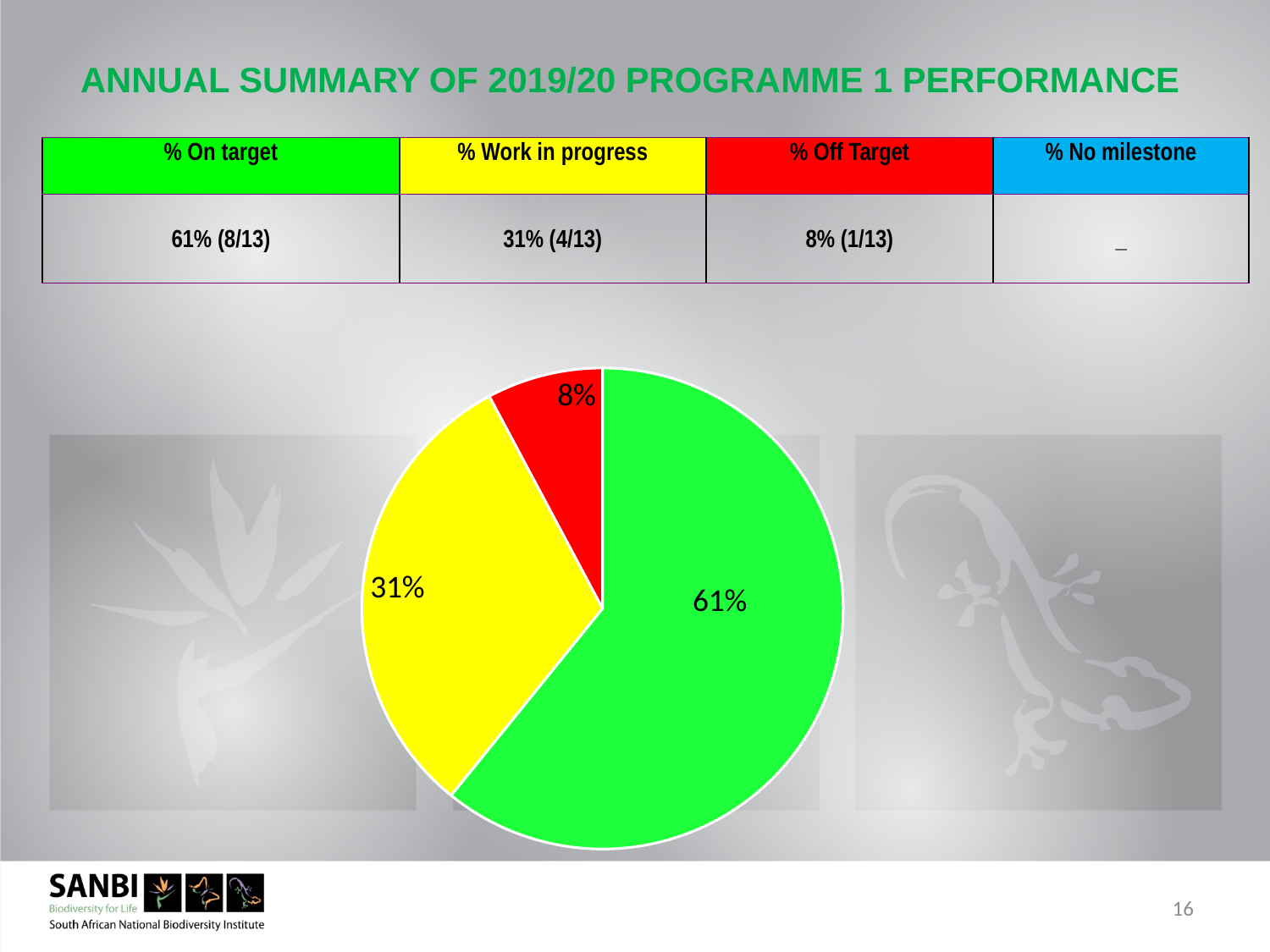
What colour is used for the largest slice of the pie chart? green Which is larger in the pie chart, the yellow slice or the red slice? the yellow slice How many slices does the pie chart have? 3 What percentage is shown on the green slice of the pie chart? 61% Which slice of the pie chart is the smallest? the red slice (8%) What percentage is shown on the yellow slice of the pie chart? 31% According to the table above the pie chart, what percentage of Programme 1 targets were on target? 61% (8/13) What percentage is shown on the red slice of the pie chart? 8% Which slice of the pie chart is the largest? the green slice (61%) What kind of chart is shown on the slide? pie chart What is the difference between the green slice and the yellow slice in the pie chart? 30% What is the difference between the yellow slice and the red slice in the pie chart? 23%